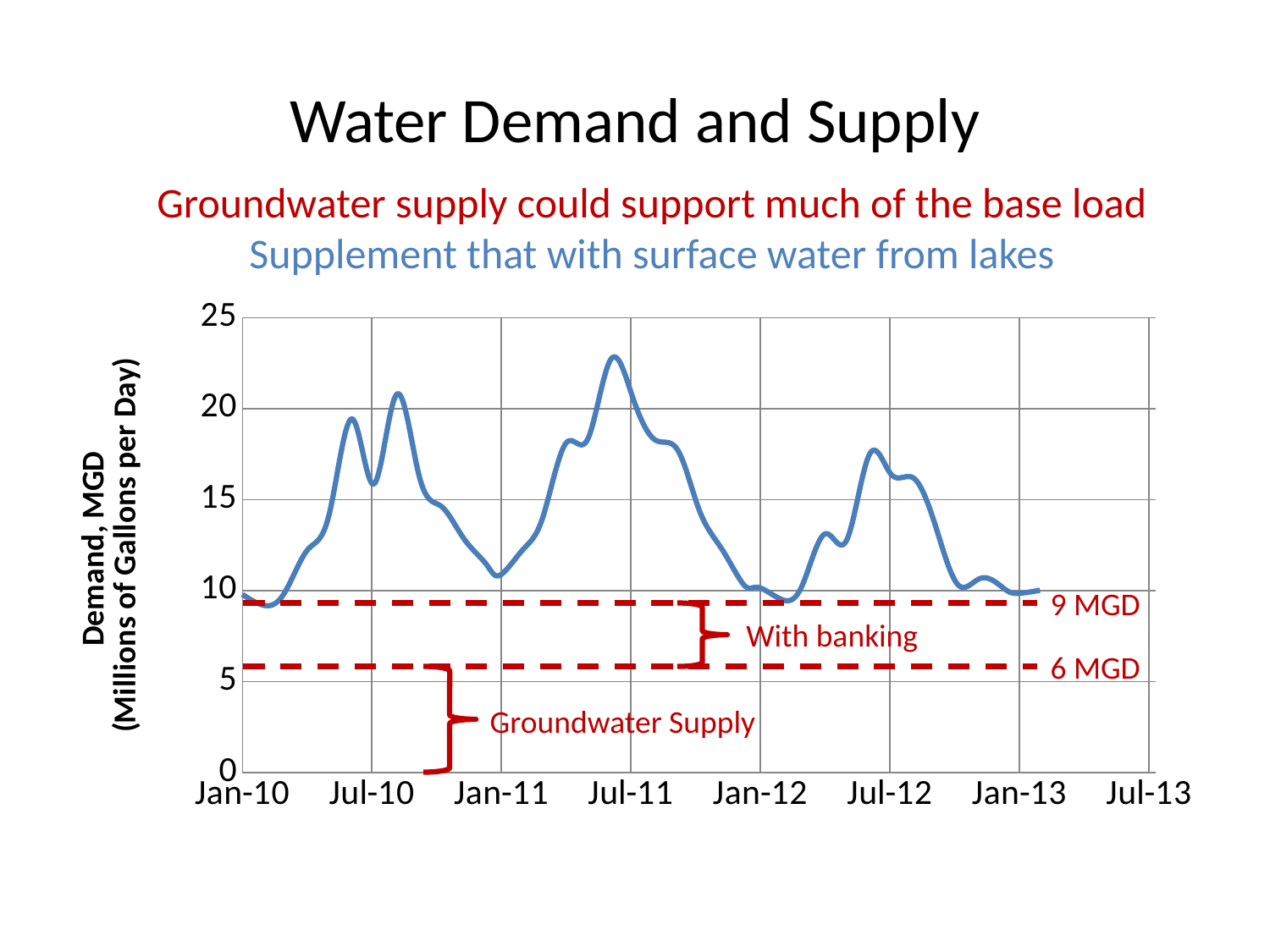
Is the peak demand value around Jul-11 greater or less than 20? greater At what value is the upper dashed line, reached "With banking", drawn? 9 MGD What is the label of the vertical axis? Demand, MGD (Millions of Gallons per Day) In which year does the demand line reach its highest peak? 2011 What is the title of the chart on the slide? Water Demand and Supply At what value is the dashed line labelled "Groundwater Supply" drawn? 6 MGD Is the peak demand value around Jul-12 greater or less than 20? less Is the demand value at Jan-12 greater or less than 15? less Which summer peak is higher, the one in 2011 or the one in 2012? 2011 What kind of chart is shown on the slide? line chart Does demand rise or fall between Jul-11 and Jan-12? fall How many tick labels are shown on the horizontal axis? 8